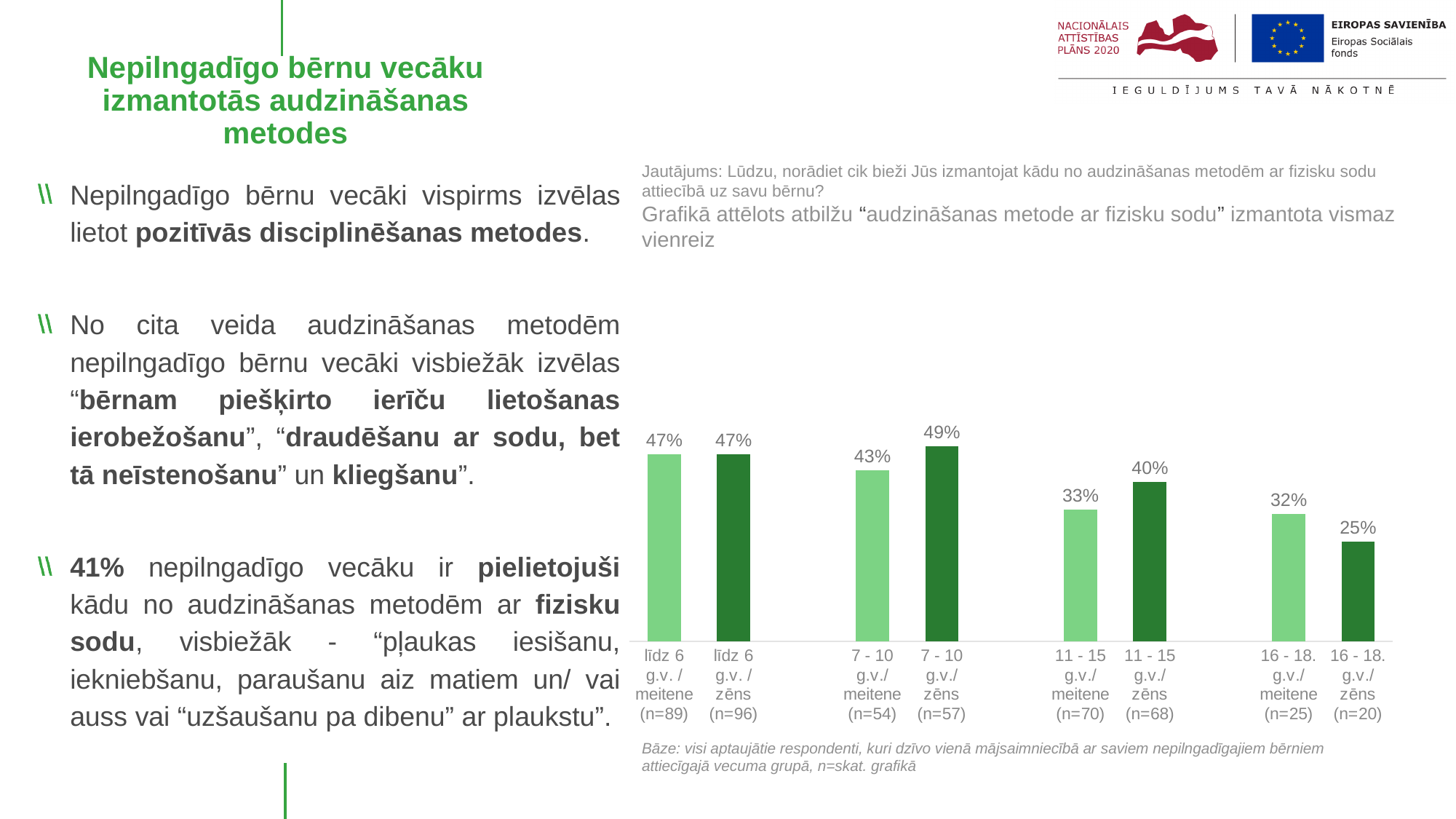
Which category has the highest value? 7 - 10 g.v./ zēns (n=57) How many bars are shown in the chart? 8 What is the value for "16 - 18. g.v./ zēns (n=20)"? 25% What is the value for "7 - 10 g.v./ zēns (n=57)"? 49% What is the difference between the values for "11 - 15 g.v./ zēns (n=68)" and "11 - 15 g.v./ meitene (n=70)"? 7% What is the value for "11 - 15 g.v./ meitene (n=70)"? 33% What is the difference between the values for "7 - 10 g.v./ zēns (n=57)" and "7 - 10 g.v./ meitene (n=54)"? 6% What kind of chart is shown on the slide? Bar chart Which category has the lowest value? 16 - 18. g.v./ zēns (n=20) What is the sample size (n) shown for the "līdz 6 g.v. / zēns" category? n=96 What is the value for "līdz 6 g.v. / meitene (n=89)"? 47% Which is larger, the value for "16 - 18. g.v./ meitene (n=25)" or "16 - 18. g.v./ zēns (n=20)"? 16 - 18. g.v./ meitene (n=25)